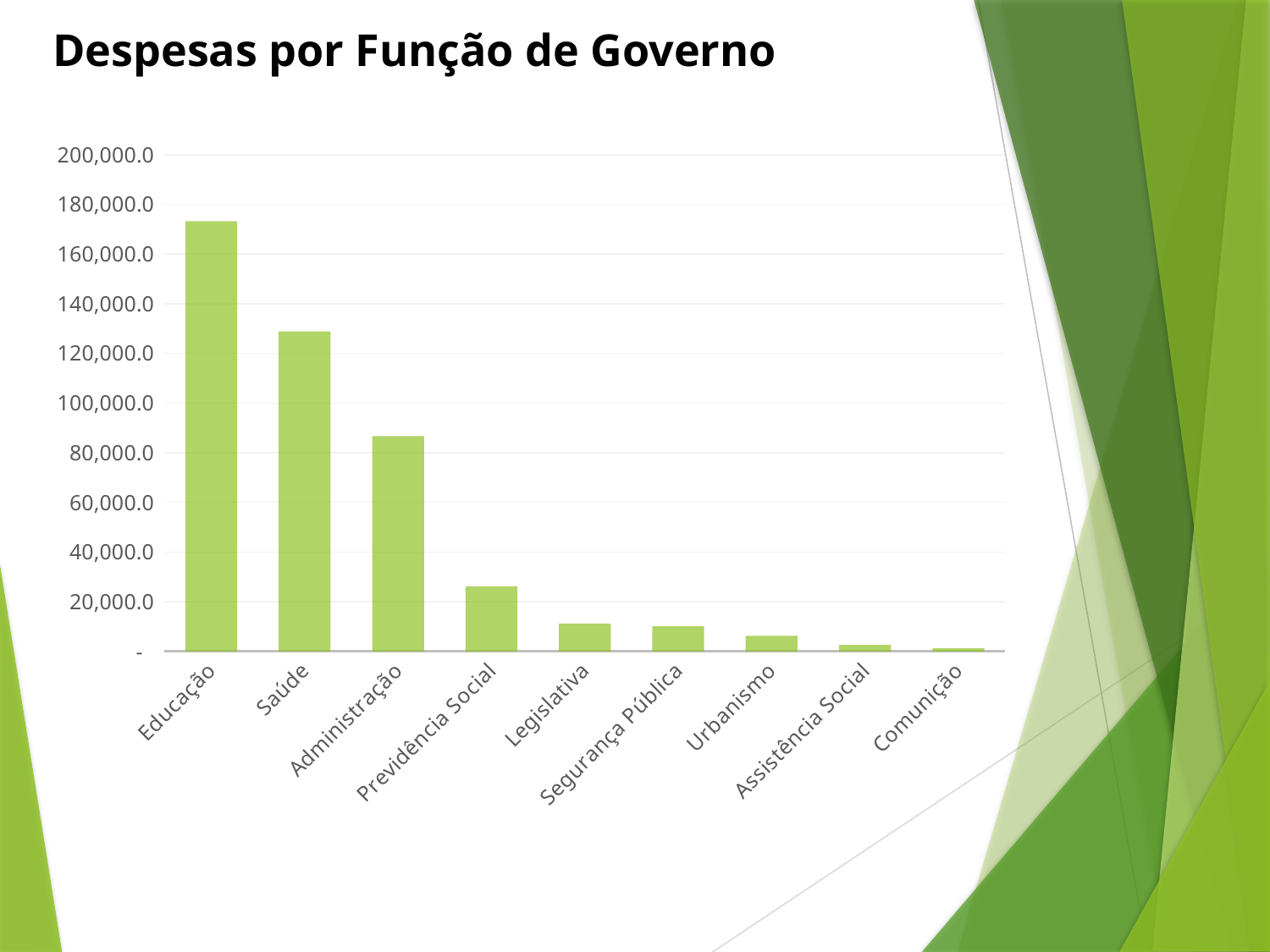
Is the value for Previdência Social greater or less than 40,000.0? less Do the values rise or fall moving from left to right along the x axis? fall What is the title of the chart? Despesas por Função de Governo Which is larger, the value for Urbanismo or the value for Previdência Social? Previdência Social Is the value for Saúde greater or less than 140,000.0? less Is the value for Administração greater or less than 80,000.0? greater Which category has the lowest value in the chart? Comunição What kind of chart is shown on the slide? bar chart Which is larger, the value for Saúde or the value for Administração? Saúde Which category has the highest value in the chart? Educação How many categories are shown on the x axis of the chart? 9